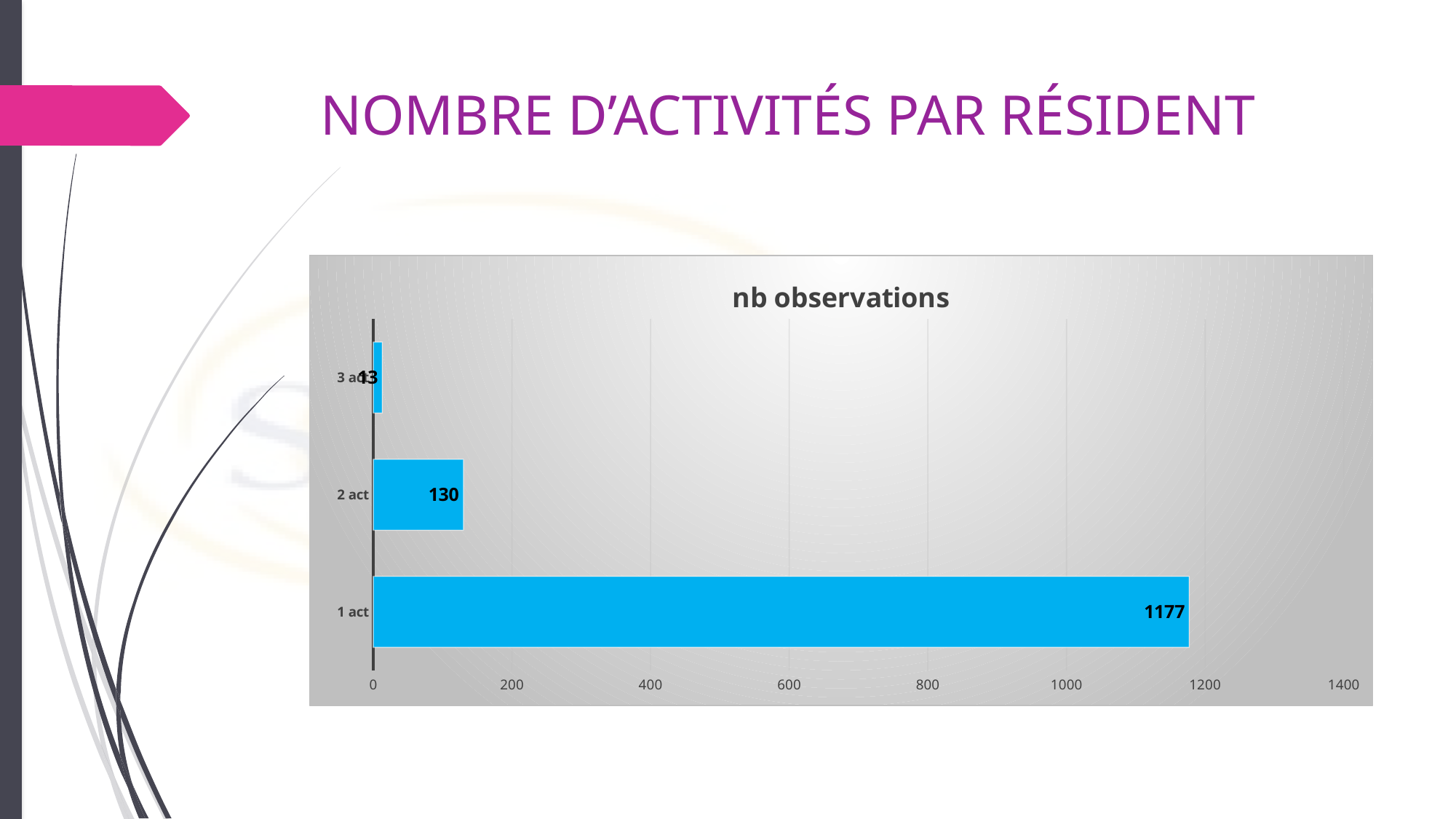
What is the value for 2 act? 130 What kind of chart is shown on the slide? bar chart What is the value for 3 act? 13 What is the value for 1 act? 1177 How many categories are shown in the chart? 3 What is the title of the chart? nb observations What is the difference between the values for 1 act and 2 act? 1047 Is the value for 1 act greater or less than 1000? greater Which is larger, the value for 2 act or the value for 3 act? 2 act Which category has the highest value? 1 act What is the difference between the values for 2 act and 3 act? 117 Which category has the lowest value? 3 act